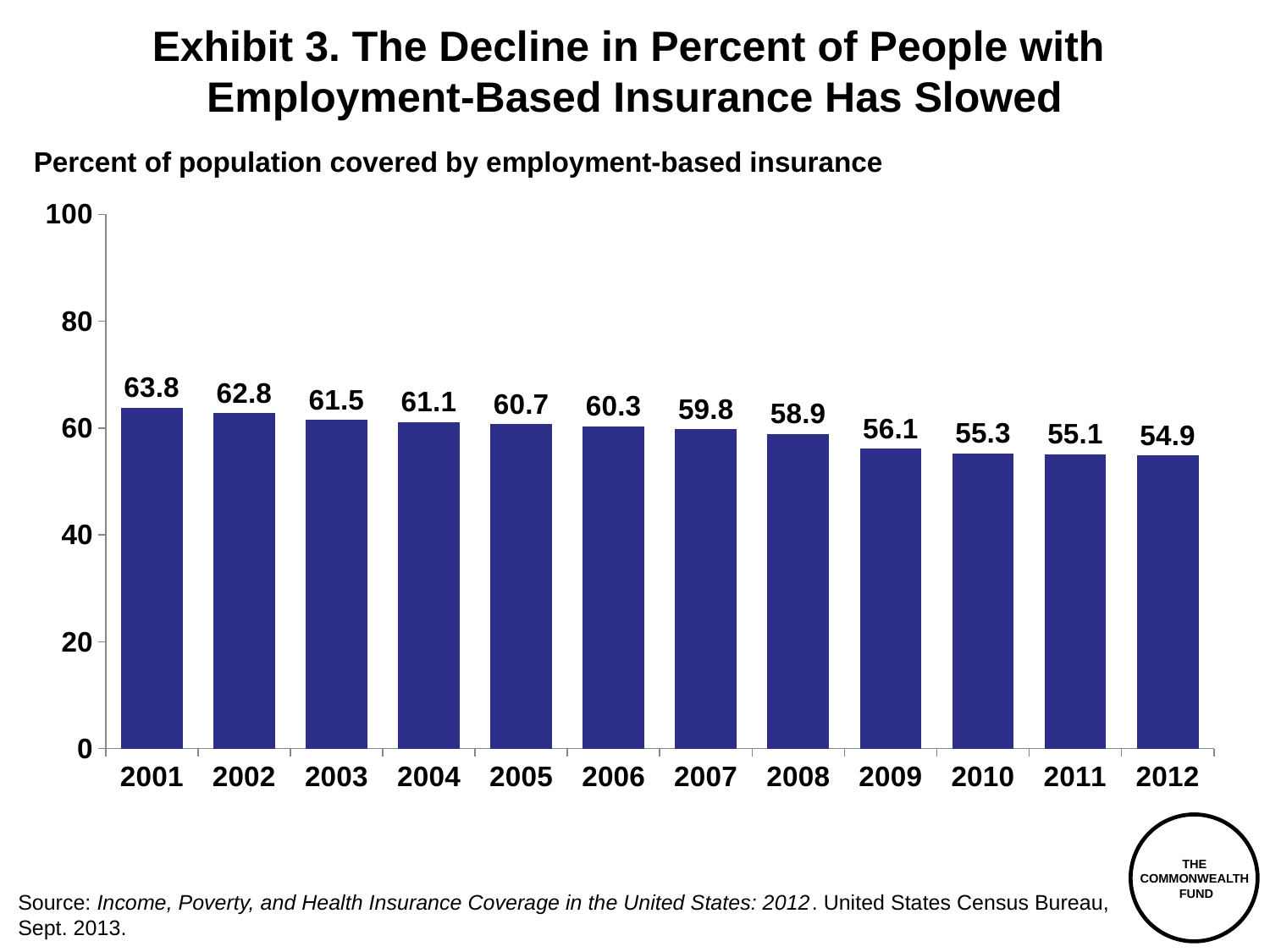
Do the values rise or fall from 2001 to 2012? Fall What is the difference between the values for 2008 and 2009? 2.8 How many years are shown on the x axis? 12 What is the value shown for 2012? 54.9 What kind of chart is shown on the slide? Bar chart Which year has the lowest percent of population covered by employment-based insurance? 2012 What percent of the population was covered by employment-based insurance in 2001? 63.8 Is the value for 2003 greater or less than 60? greater Which year has a higher value, 2005 or 2010? 2005 What is the value shown for 2009? 56.1 Which year has the highest percent of population covered by employment-based insurance? 2001 By how many percentage points did the value fall from 2001 to 2012? 8.9